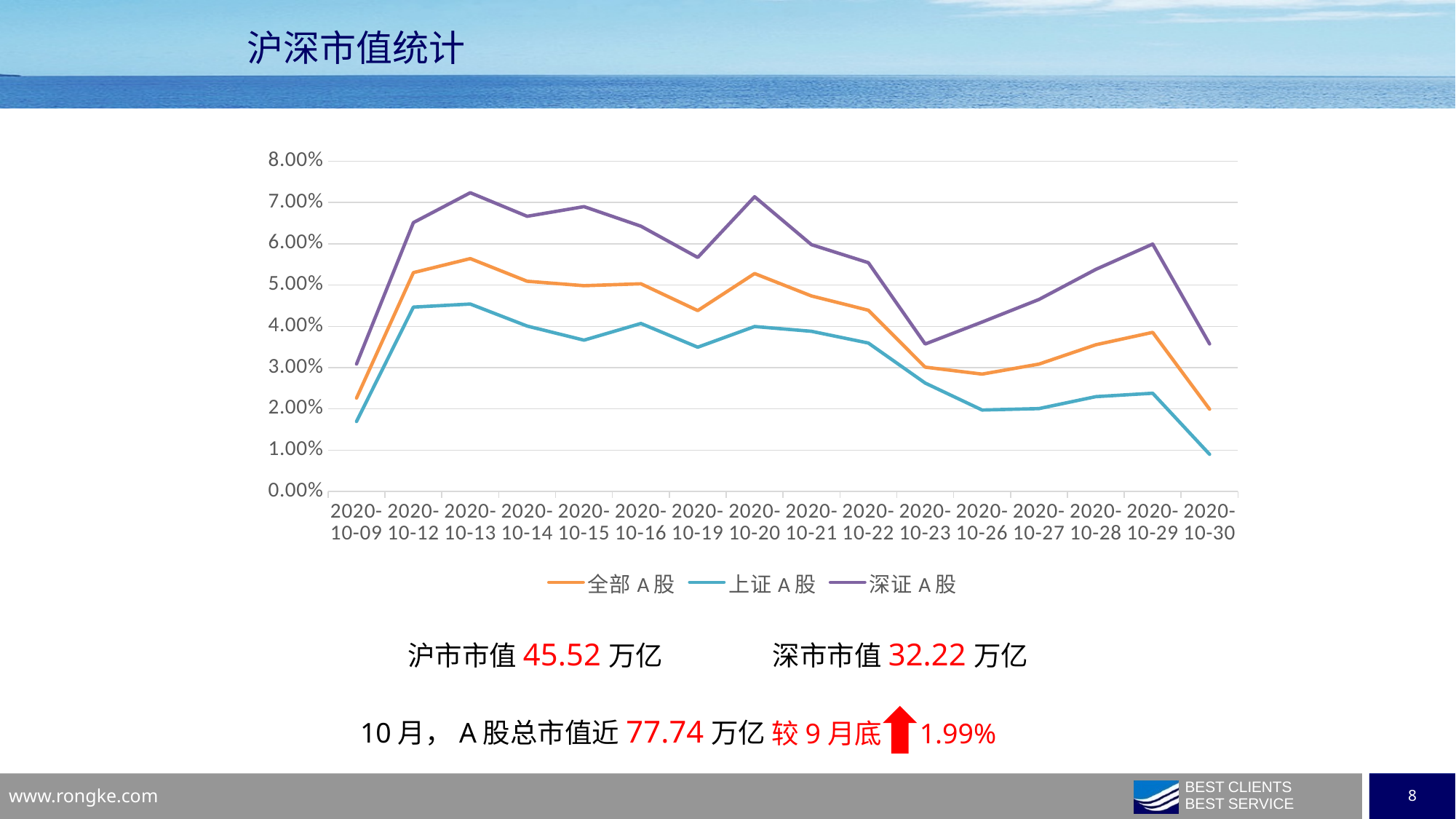
On which date does 上证 A 股 reach its lowest value? 2020-10-30 How many dates are plotted along the x axis? 16 Does the 深证 A 股 line rise or fall from 2020-10-23 to 2020-10-29? rise What colour is the 全部 A 股 line in the legend? orange Is the value for 全部 A 股 on 2020-10-29 greater or less than 3.00%? greater Is the value for 深证 A 股 on 2020-10-13 greater or less than 7.00%? greater What kind of chart is shown on the slide? line chart Which series has the highest value on 2020-10-20? 深证 A 股 On which date does 全部 A 股 reach its highest value? 2020-10-13 How many series does the legend list? 3 On 2020-10-09, which is lower: 上证 A 股 or 深证 A 股? 上证 A 股